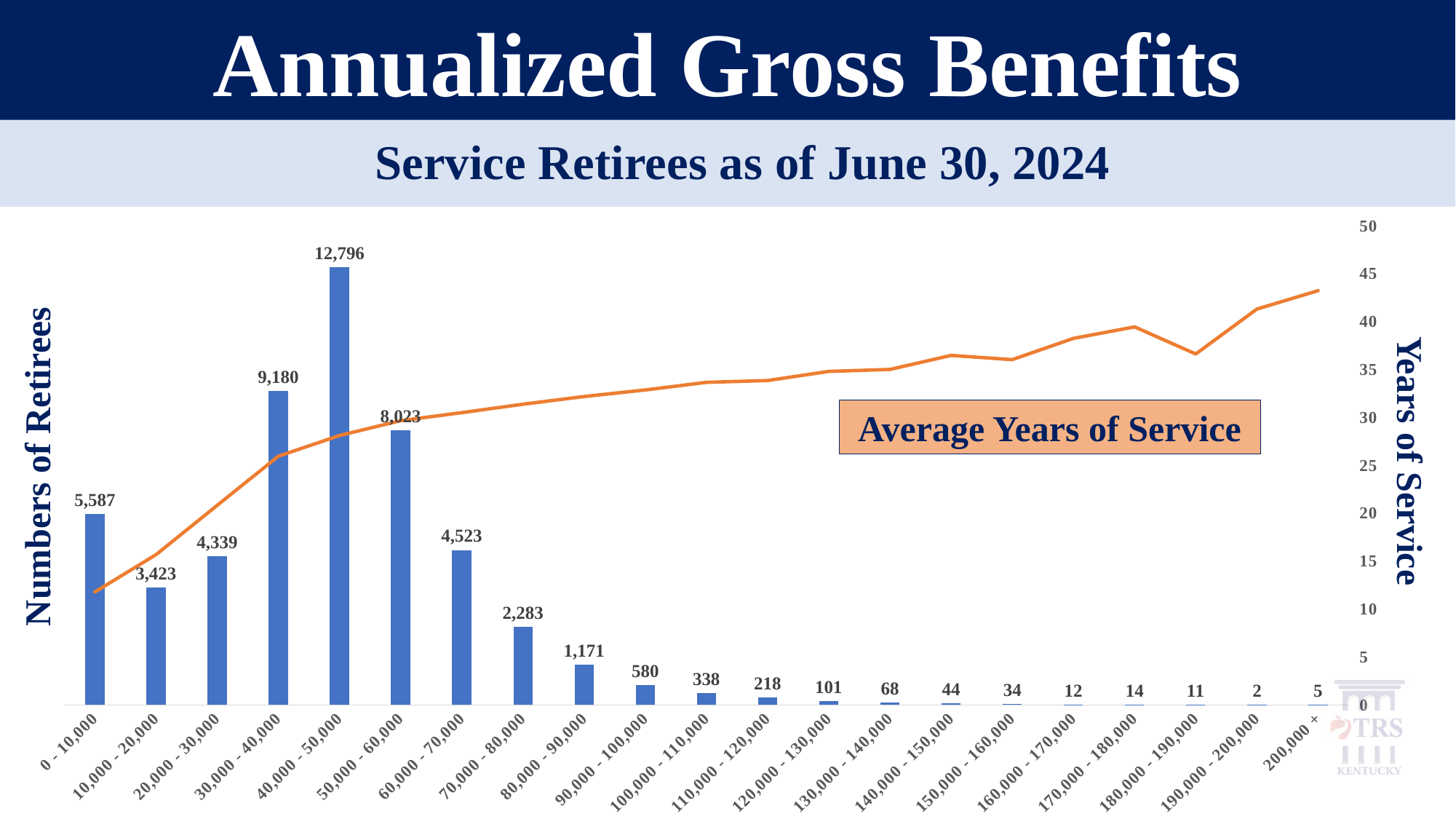
Which benefit range has the highest number of retirees? 40,000 - 50,000 Which benefit range has the lowest number of retirees? 190,000 - 200,000 What does the orange line represent? Average Years of Service What is the difference in the number of retirees between the 40,000 - 50,000 range and the 30,000 - 40,000 range? 3,616 Is the average years of service for the 200,000 + range greater or less than 40? greater How many retirees are in the 90,000 - 100,000 benefit range? 580 How many retirees are in the 0 - 10,000 benefit range? 5,587 Which has more retirees, the 20,000 - 30,000 range or the 10,000 - 20,000 range? 20,000 - 30,000 Is the average years of service for the 0 - 10,000 range greater or less than 15? less Does the average years of service line generally rise or fall as the benefit range increases? rise How many retirees are in the 40,000 - 50,000 benefit range? 12,796 How many benefit range categories are shown on the x axis? 21